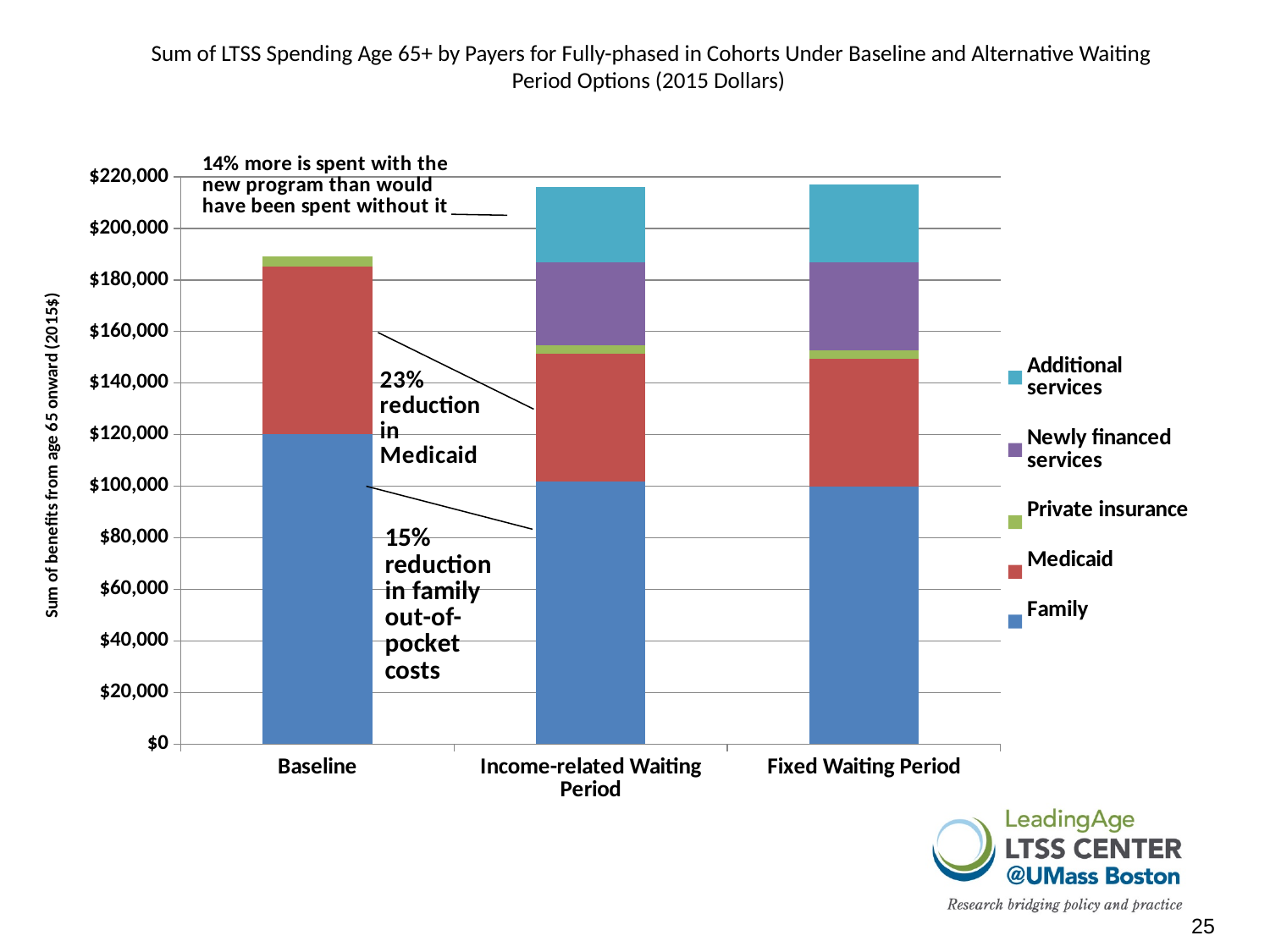
How many categories (bars) are shown on the x axis? 3 What kind of chart is shown on the slide? Stacked bar chart Is the Family segment for Baseline greater or less than $100,000? greater Which series appears at the top of the Income-related Waiting Period and Fixed Waiting Period bars? Additional services Which category has the lowest total bar height? Baseline Which has the larger Family segment, Baseline or Fixed Waiting Period? Baseline Is the total bar for Income-related Waiting Period greater or less than $200,000? greater Which has the larger total bar, Baseline or Income-related Waiting Period? Income-related Waiting Period How many series does the legend list? 5 According to the annotation on the chart, what is the percentage reduction in Medicaid? 23% Is the total bar for Baseline greater or less than $180,000? greater